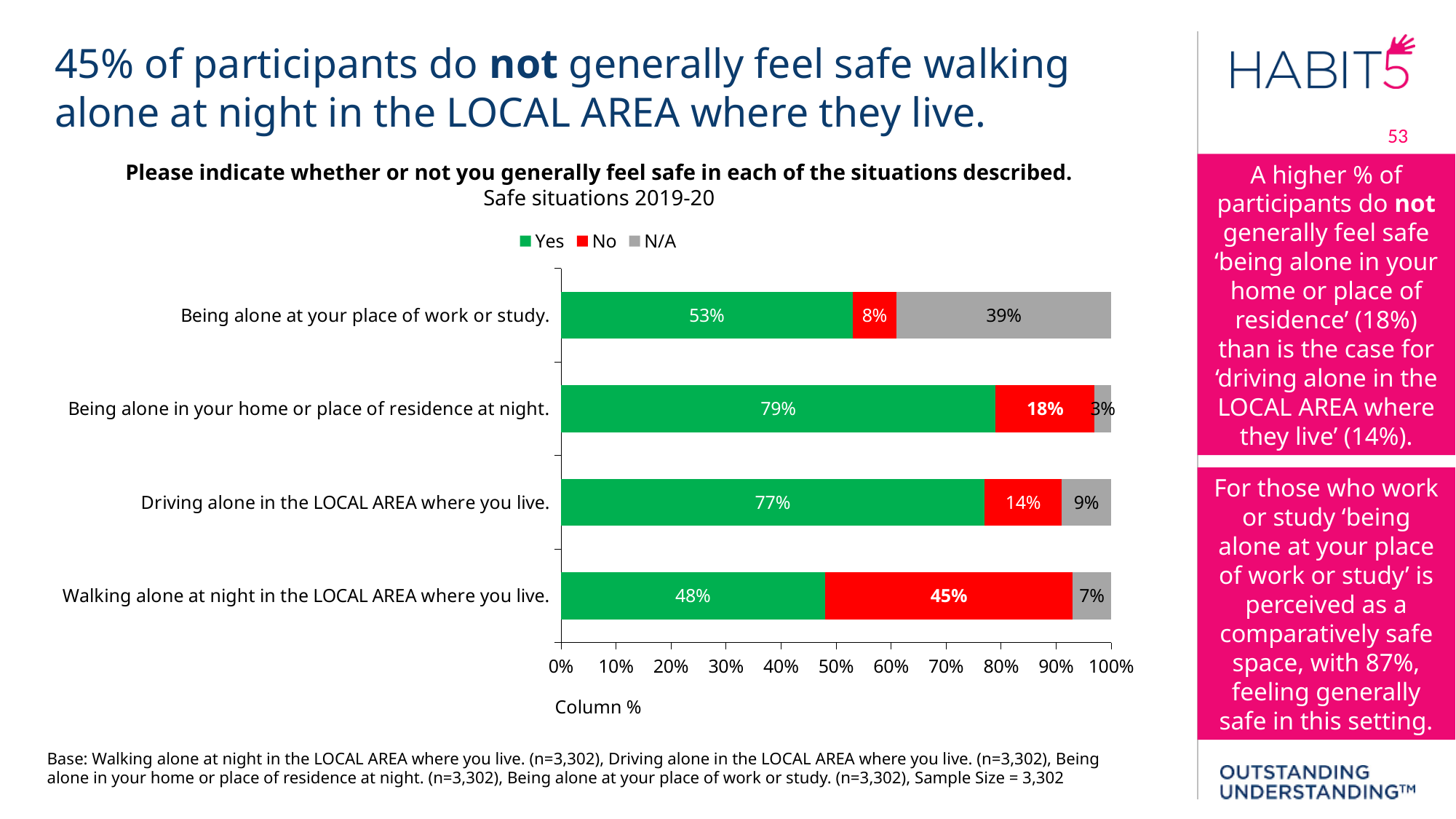
What is the 'N/A' value for 'Being alone at your place of work or study.'? 39% What is the difference between the 'No' values for 'Being alone in your home or place of residence at night.' and 'Driving alone in the LOCAL AREA where you live.'? 4% What percentage of participants answered 'Yes' for 'Walking alone at night in the LOCAL AREA where you live.'? 48% Which situation has the lowest 'Yes' percentage? Walking alone at night in the LOCAL AREA where you live. How many situations (categories) are shown in the chart? 4 What kind of chart is shown on the slide? Stacked bar chart How many series does the legend list? 3 Which situation has the highest 'No' percentage? Walking alone at night in the LOCAL AREA where you live. What is the 'Yes' value for 'Driving alone in the LOCAL AREA where you live.'? 77% What is the 'No' value for 'Being alone in your home or place of residence at night.'? 18% Which is larger: the 'Yes' value for 'Being alone in your home or place of residence at night.' or the 'Yes' value for 'Driving alone in the LOCAL AREA where you live.'? Being alone in your home or place of residence at night. What colour represents the 'No' series in the chart? Red